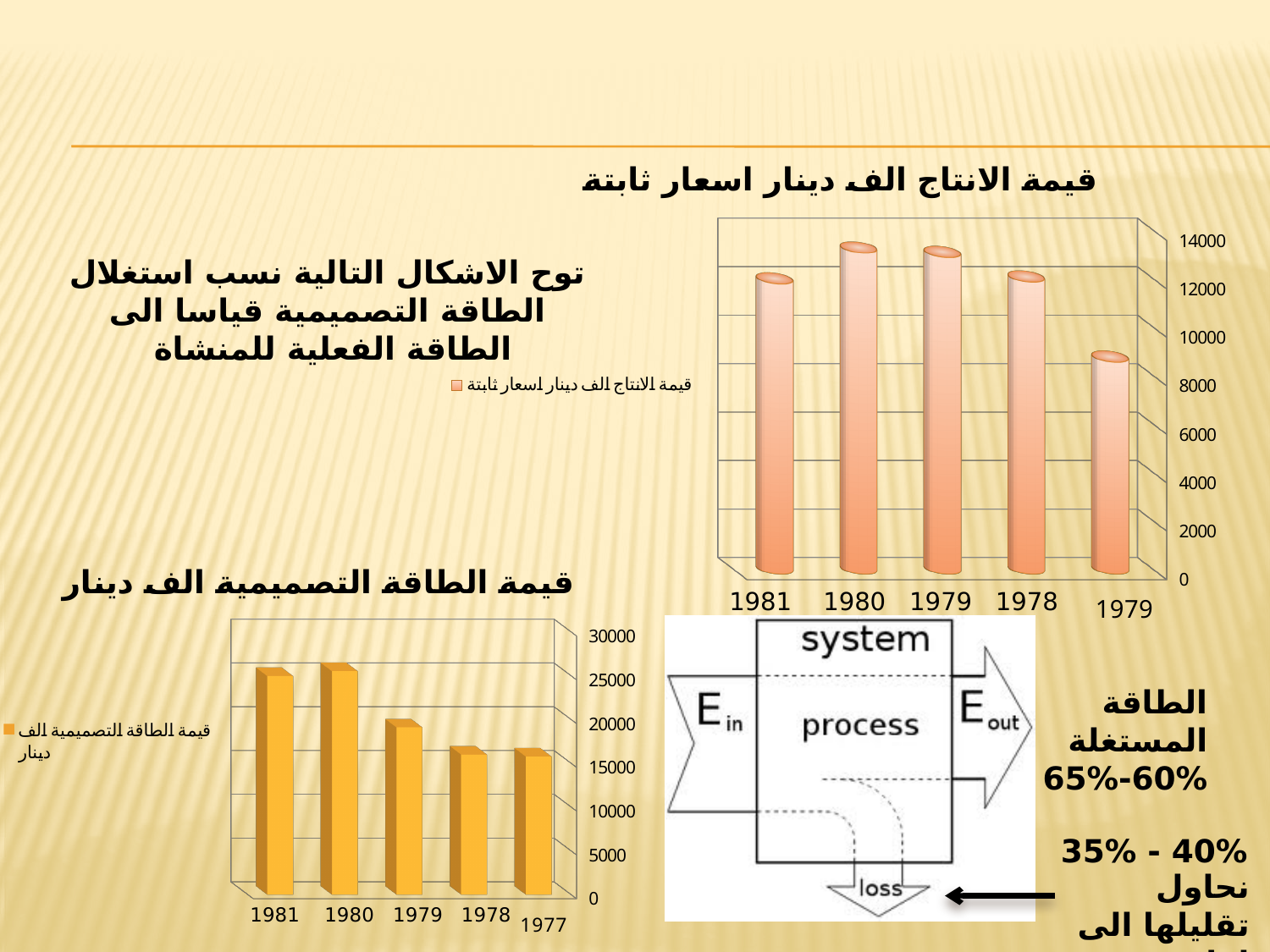
In the bottom-left chart "قيمة الطاقة التصميمية الف دينار", is the value for 1978 greater or less than 20000? less In the top-right chart "قيمة الانتاج الف دينار اسعار ثابتة", which bar is the lowest? The rightmost bar What kind of chart is the top-right chart titled "قيمة الانتاج الف دينار اسعار ثابتة"? Bar chart In the top-right chart "قيمة الانتاج الف دينار اسعار ثابتة", is the value for 1981 greater or less than 10000? greater In the bottom-left chart "قيمة الطاقة التصميمية الف دينار", which is larger, the value for 1981 or the value for 1979? 1981 How many categories are shown on the x axis of the bottom-left chart "قيمة الطاقة التصميمية الف دينار"? 5 What kind of chart is the bottom-left chart titled "قيمة الطاقة التصميمية الف دينار"? Bar chart How many bars are plotted in the top-right chart "قيمة الانتاج الف دينار اسعار ثابتة"? 5 How many series does the legend of the bottom-left chart "قيمة الطاقة التصميمية الف دينار" list? 1 In the bottom-left chart "قيمة الطاقة التصميمية الف دينار", do the values generally rise or fall moving from left to right along the x axis? Fall In the top-right chart "قيمة الانتاج الف دينار اسعار ثابتة", is the value of the rightmost bar greater or less than 10000? less